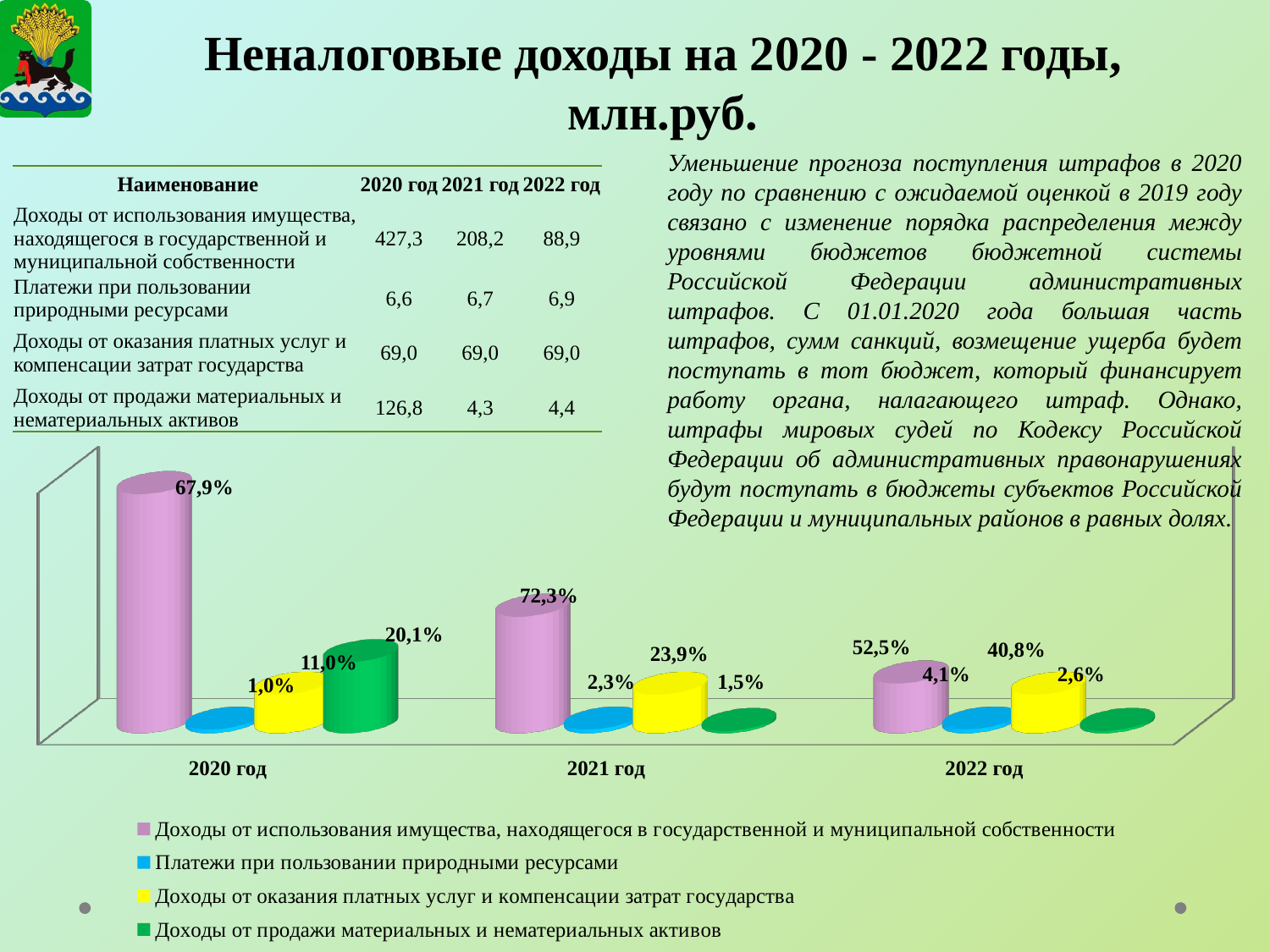
What is the value for 'Доходы от продажи материальных и нематериальных активов' in 2021 год? 1,5% Which is larger in 2021 год: 'Доходы от оказания платных услуг и компенсации затрат государства' or 'Доходы от продажи материальных и нематериальных активов'? Доходы от оказания платных услуг и компенсации затрат государства Which series has the lowest value in 2020 год? Платежи при пользовании природными ресурсами What kind of chart is shown on the slide? bar chart How many year categories are shown on the x axis of the chart? 3 What is the value for 'Платежи при пользовании природными ресурсами' in 2022 год? 4,1% How many series does the chart legend list? 4 What is the value for 'Доходы от использования имущества, находящегося в государственной и муниципальной собственности' in 2020 год? 67,9% What is the difference between the 2020 год and 2022 год values for 'Доходы от использования имущества, находящегося в государственной и муниципальной собственности'? 15,4% What is the value for 'Доходы от оказания платных услуг и компенсации затрат государства' in 2022 год? 40,8%